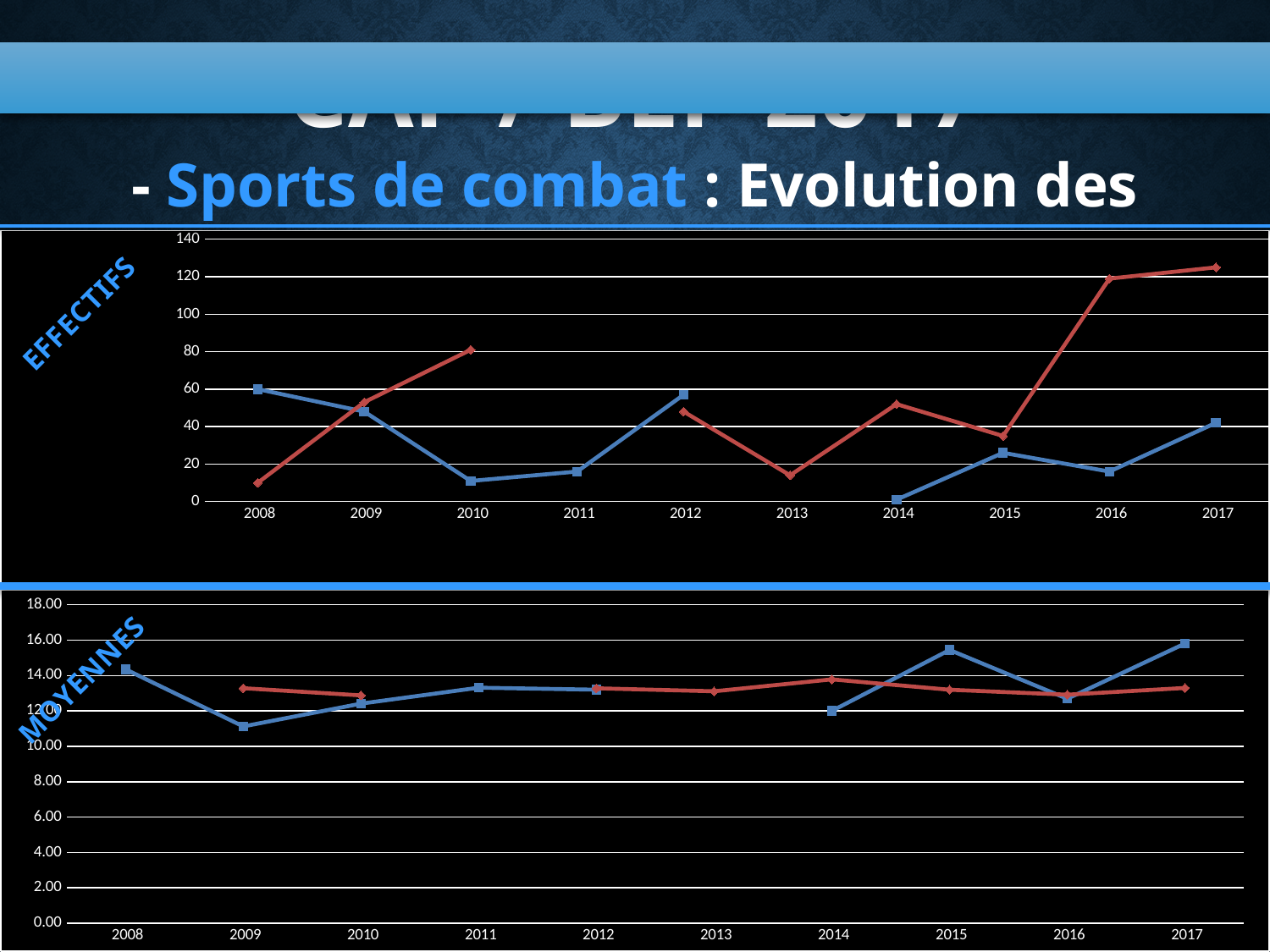
In the top chart (EFFECTIFS), which line has the higher value in 2008, the blue line or the red line? Blue line In the bottom chart (MOYENNES), is the blue line's value for 2009 greater or less than 12.00? less What kind of chart is the top chart labelled EFFECTIFS? Line chart What is the label written beside the top chart? EFFECTIFS In the top chart (EFFECTIFS), is the red line's value for 2016 greater or less than 100? greater In the bottom chart (MOYENNES), which line has the higher value in 2015, the blue line or the red line? Blue line What kind of chart is the bottom chart labelled MOYENNES? Line chart In the top chart (EFFECTIFS), in which year does the red line reach its highest value? 2017 In the top chart (EFFECTIFS), in which year does the blue line reach its lowest value? 2014 In the top chart (EFFECTIFS), is the blue line's value for 2010 greater or less than 20? less In the top chart (EFFECTIFS), how many years are shown on the x axis? 10 In the top chart (EFFECTIFS), does the red line rise or fall from 2015 to 2017? Rise